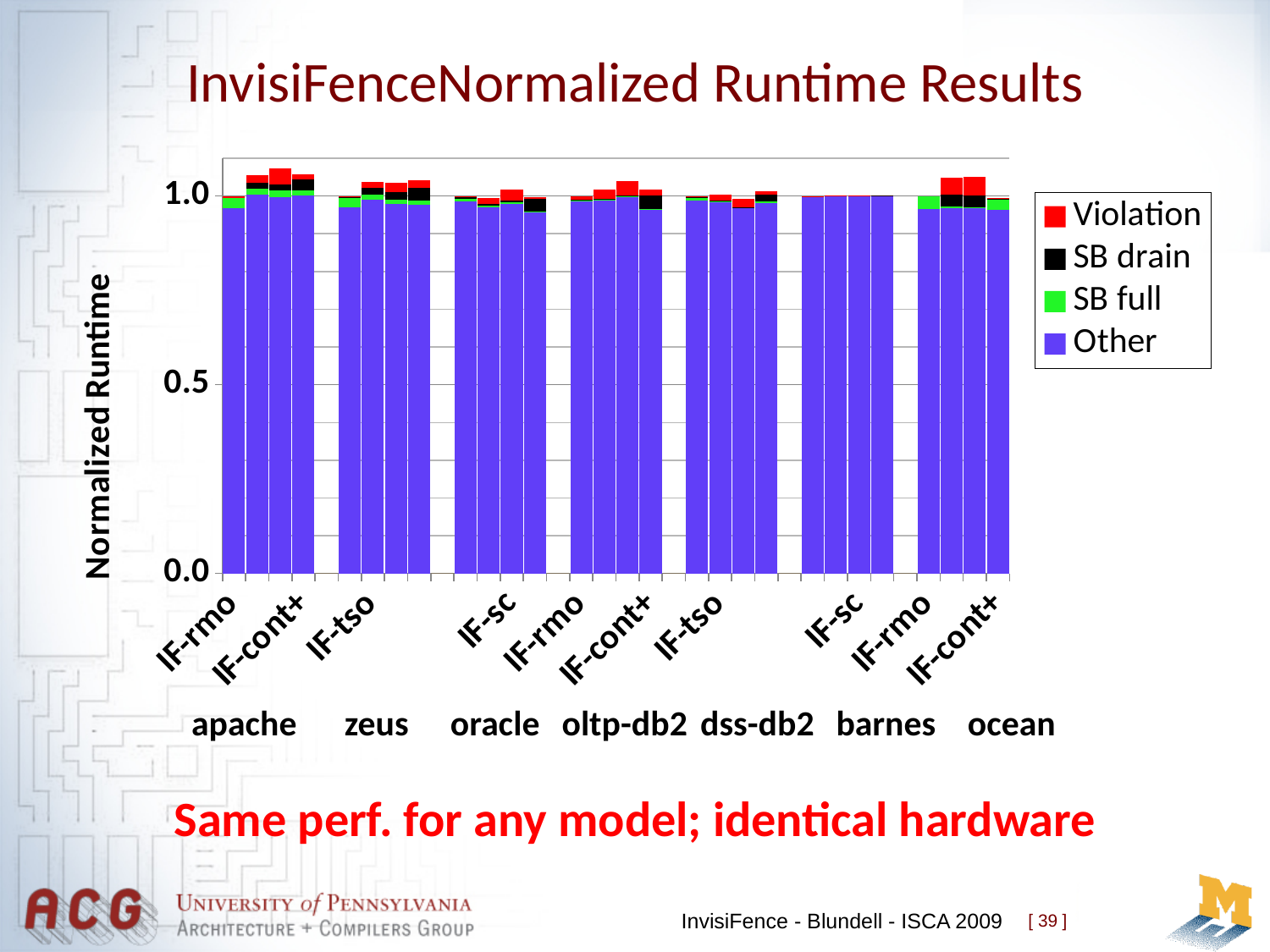
What are the series listed in the legend? Violation, SB drain, SB full, Other Is the total normalized runtime for the oltp-db2 IF-cont+ bar greater or less than 0.5? greater How many benchmark groups are shown along the x axis? 7 How many series does the legend list? 4 Is the Other segment of the apache IF-sc bar greater or less than 0.5? greater What kind of chart is shown on the slide? stacked bar chart How many bars are plotted for each benchmark group? 4 What is the label of the y axis? Normalized Runtime Is the total normalized runtime for the apache IF-cont+ bar greater or less than 1.0? greater